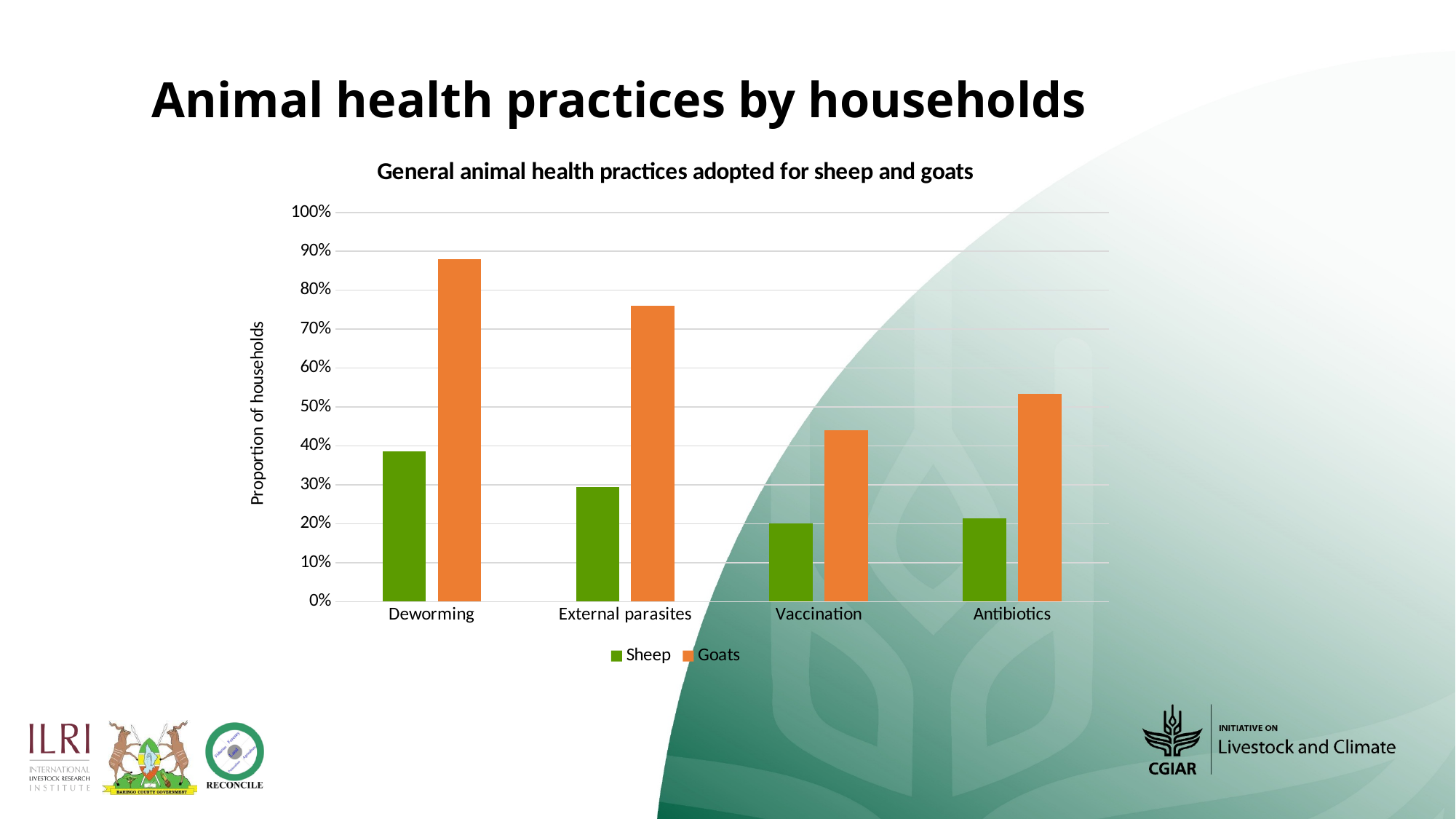
What type of chart is shown on the slide? bar chart How many categories are shown on the x axis? 4 Which category has the highest value for Sheep? Deworming Which is larger for Deworming, the value for Sheep or the value for Goats? Goats Is the value for Goats in Antibiotics greater or less than 50%? greater What is the title of the chart? General animal health practices adopted for sheep and goats Is the value for Goats in Deworming greater or less than 80%? greater Which category has the highest value for Goats? Deworming Is the value for Goats in Vaccination greater or less than 50%? less How many series does the legend list? 2 Which category has the lowest value for Goats? Vaccination